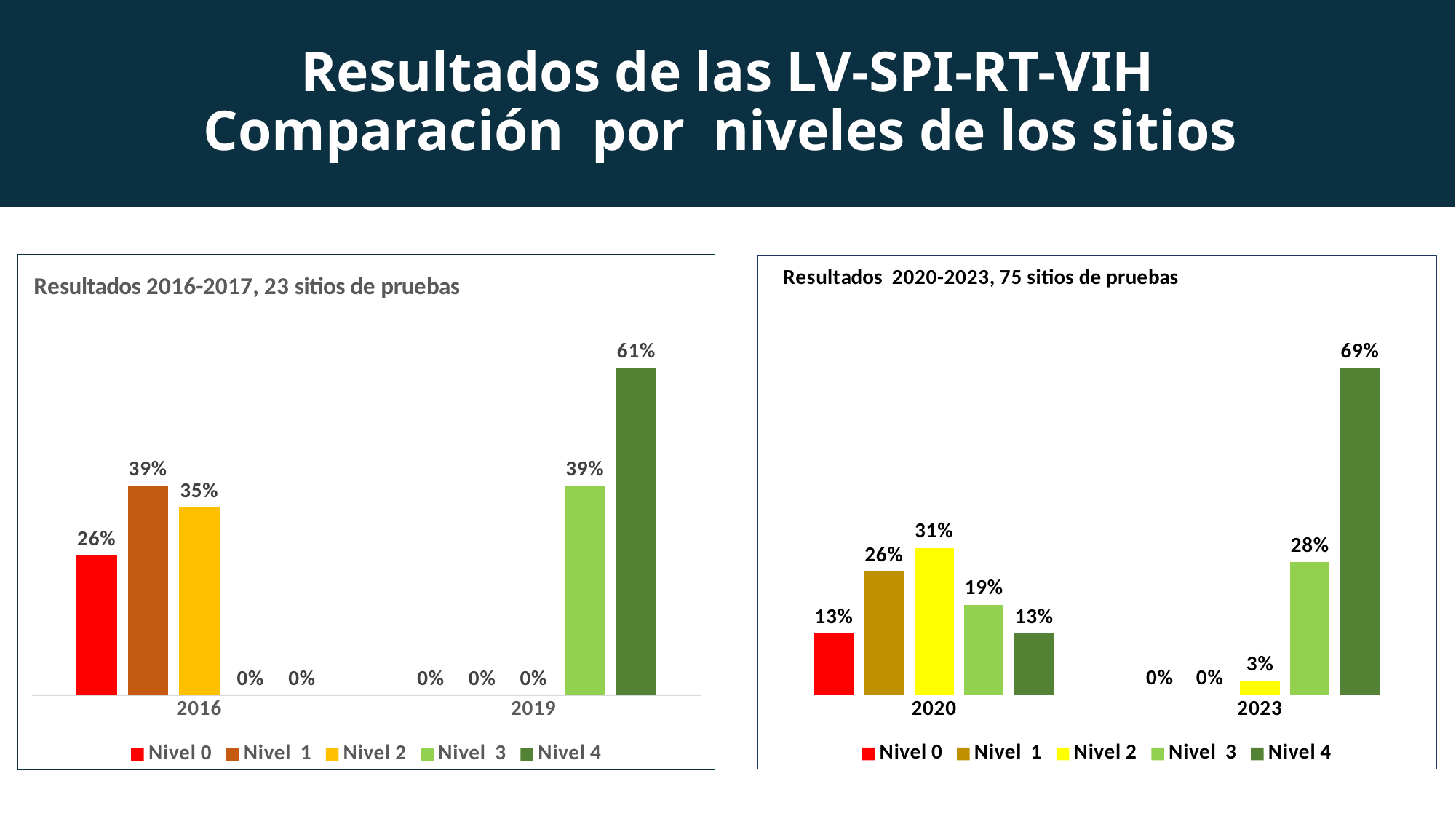
In the chart 'Resultados 2020-2023, 75 sitios de pruebas', which is larger in 2020: Nivel 1 or Nivel 3? Nivel 1 In the chart 'Resultados 2020-2023, 75 sitios de pruebas', how many year categories are shown on the x axis? 2 In the chart 'Resultados 2016-2017, 23 sitios de pruebas', what is the difference between Nivel 4 and Nivel 3 in 2019? 22% In the chart 'Resultados 2016-2017, 23 sitios de pruebas', what is the value for Nivel 1 in 2016? 39% In the chart 'Resultados 2020-2023, 75 sitios de pruebas', what is the value for Nivel 2 in 2020? 31% What kind of chart is the chart on the left of the slide? Bar chart In the chart 'Resultados 2020-2023, 75 sitios de pruebas', what is the difference between Nivel 4 in 2023 and Nivel 4 in 2020? 56% In the chart 'Resultados 2016-2017, 23 sitios de pruebas', how many series does the legend list? 5 In the chart 'Resultados 2020-2023, 75 sitios de pruebas', what is the value for Nivel 3 in 2023? 28% In the chart 'Resultados 2016-2017, 23 sitios de pruebas', which level has the highest value in 2016? Nivel 1 In the chart 'Resultados 2016-2017, 23 sitios de pruebas', what is the value for Nivel 4 in 2019? 61% In the chart 'Resultados 2020-2023, 75 sitios de pruebas', which level has the highest value in 2023? Nivel 4